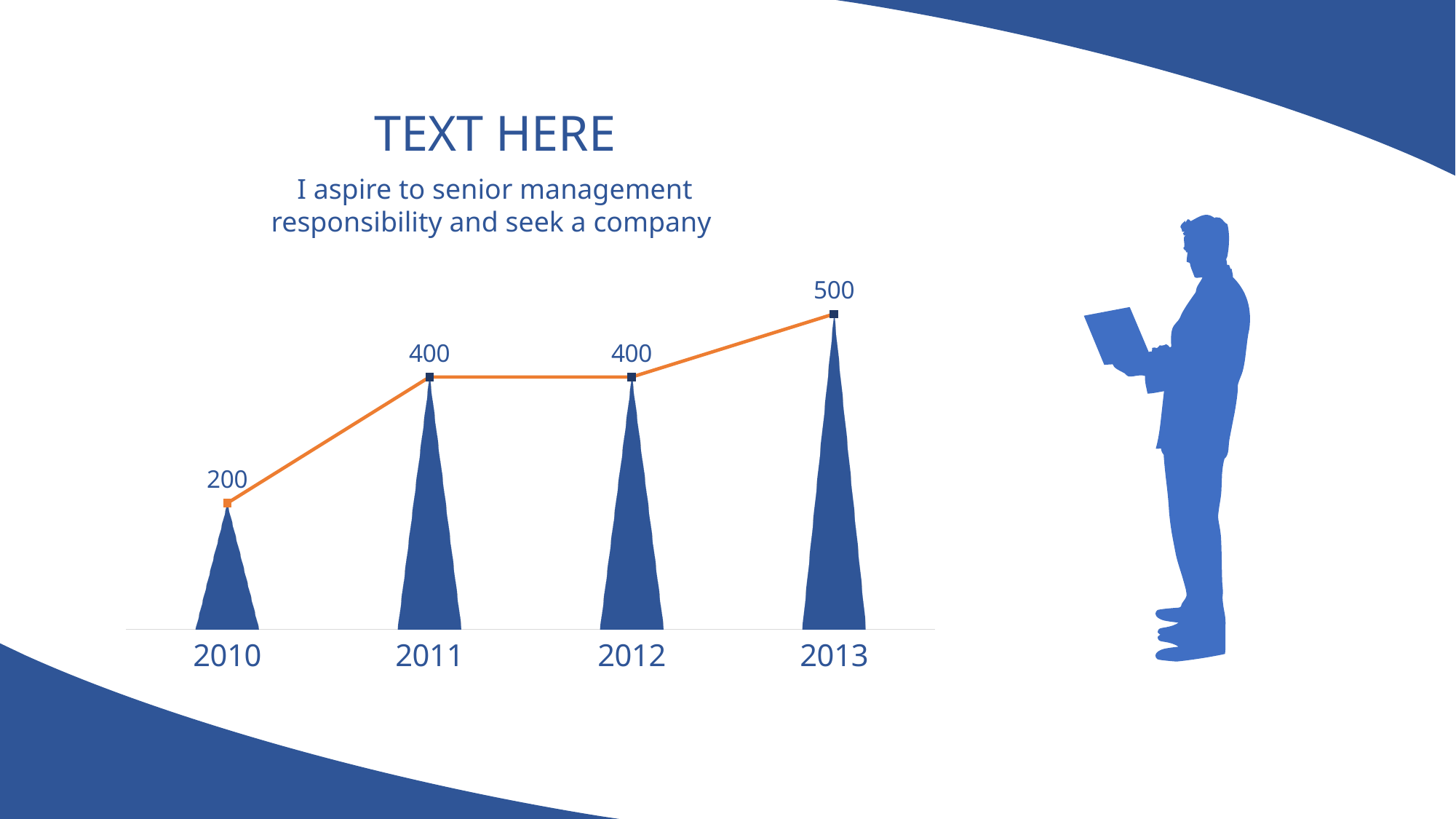
Which is larger, the value for 2012 or the value for 2013? 2013 What is the difference between the values for 2013 and 2010? 300 What is the value for 2011? 400 What is the value for 2013? 500 Which year has the lowest value? 2010 What is the title shown above the chart? TEXT HERE What is the difference between the values for 2011 and 2010? 200 Are the values for 2011 and 2012 the same or different? the same What is the value for 2010? 200 How many years are shown on the x axis? 4 Do the values generally rise or fall from 2010 to 2013? rise Which year has the highest value? 2013